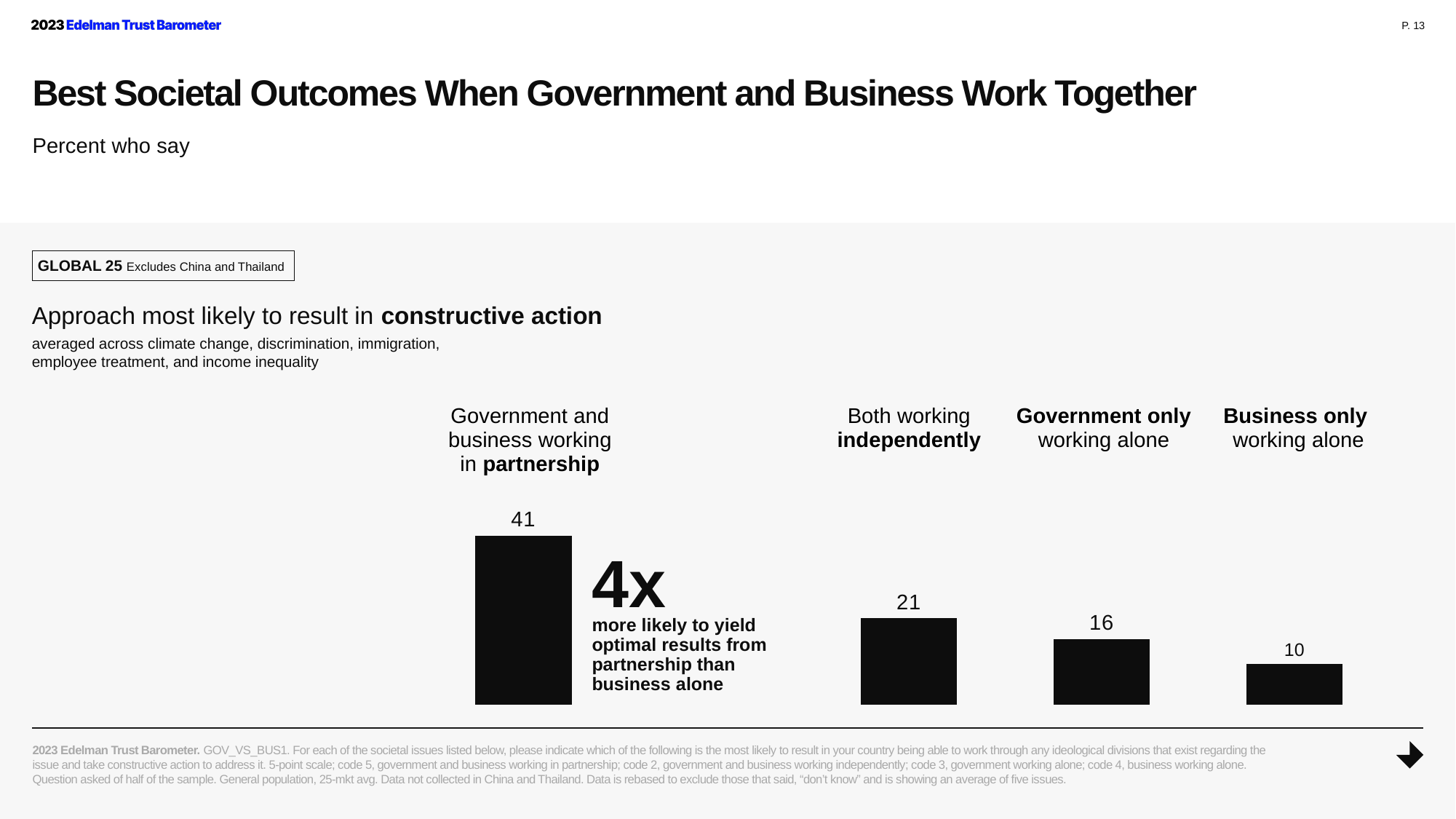
What kind of chart is shown on the slide? Bar chart According to the callout, how many times more likely is partnership to yield optimal results than business alone? 4x What is the value for government only working alone? 16 What is the difference between the values for both working independently and government only working alone? 5 How many approaches are shown in the chart? 4 What is the value for both working independently? 21 Which approach has the lowest value? Business only working alone Which is larger, the value for government only working alone or business only working alone? Government only working alone What is the value for business only working alone? 10 Which approach has the highest value? Government and business working in partnership What is the difference between the values for partnership and business only working alone? 31 What percent say government and business working in partnership is the approach most likely to result in constructive action? 41